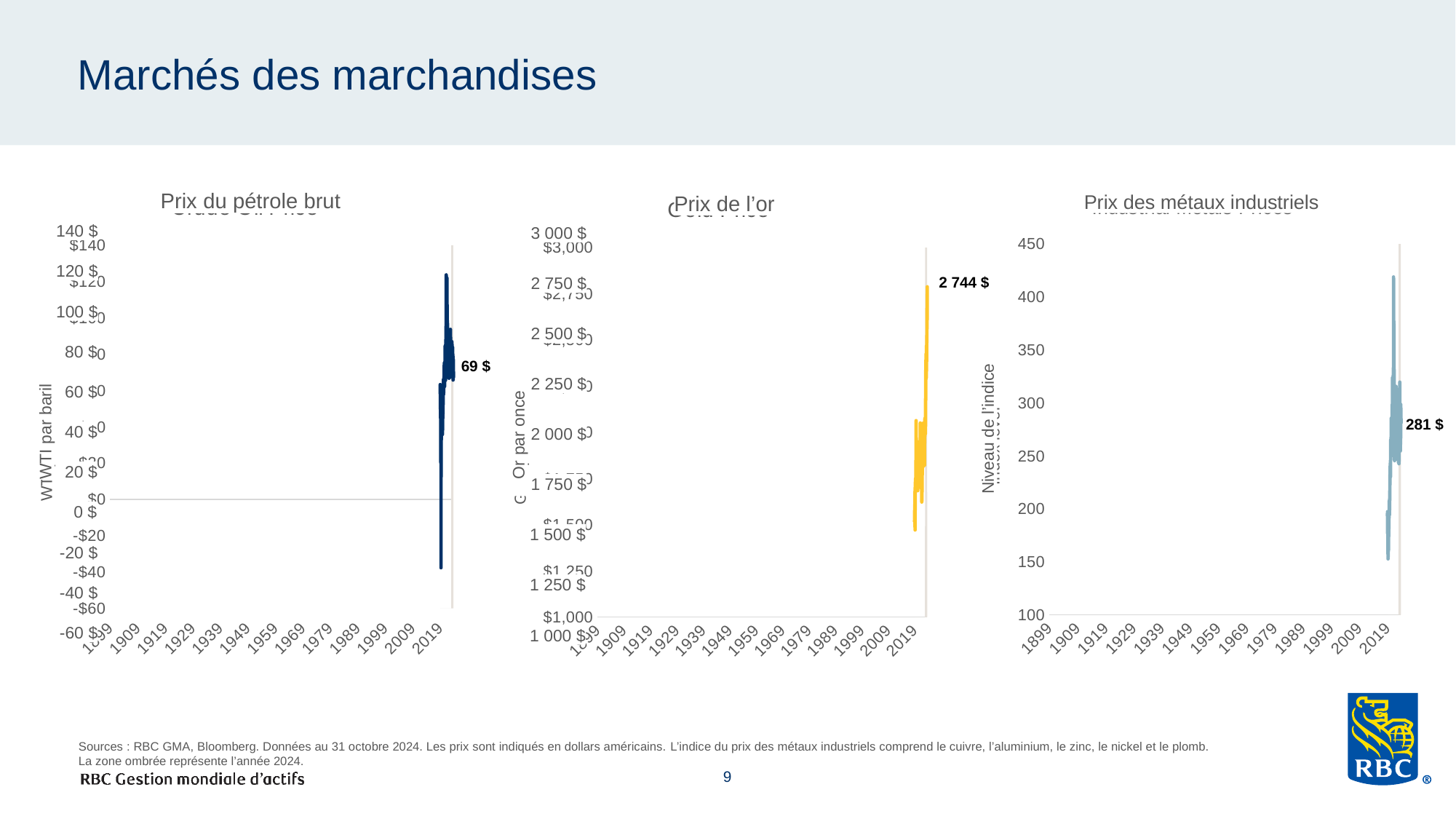
What kind of chart is the 'Prix de l'or' chart? line chart On the 'Prix du pétrole brut' chart, what is the latest value shown by the data label? 69 $ What is the y-axis label of the 'Prix des métaux industriels' chart? Niveau de l'indice On the 'Prix des métaux industriels' chart, what is the latest value shown by the data label? 281 $ What kind of chart is the 'Prix du pétrole brut' chart? line chart On the 'Prix de l'or' chart, is the latest labelled value greater or less than 2 500 $? greater What is the y-axis label of the 'Prix du pétrole brut' chart? WTI par baril On the 'Prix du pétrole brut' chart, is the latest labelled value greater or less than 80 $? less On the 'Prix de l'or' chart, what is the latest value shown by the data label? 2 744 $ On the 'Prix du pétrole brut' chart, is the lowest point of the line greater or less than 0 $? less How many charts are shown on the slide? 3